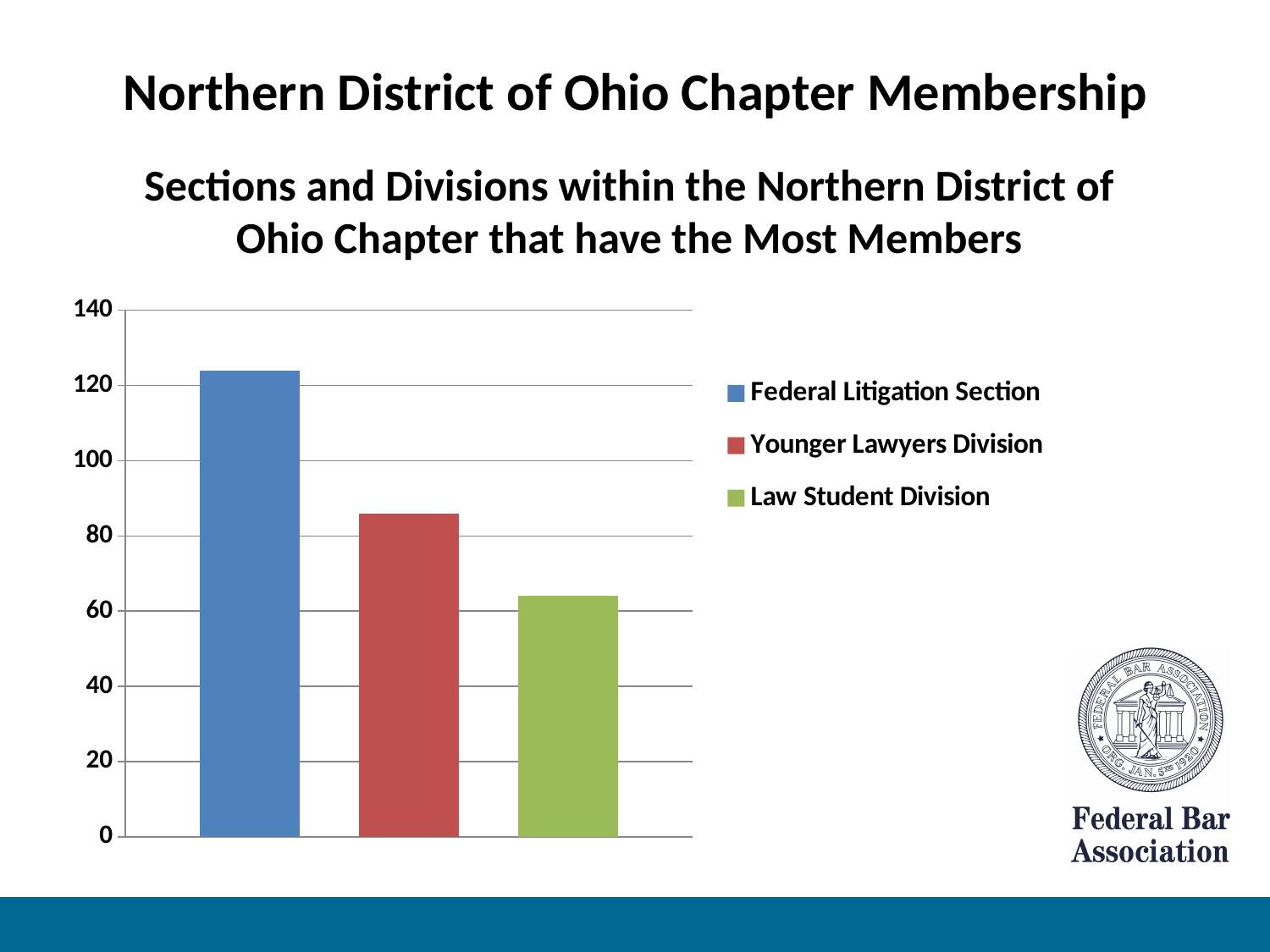
Which section or division has the highest number of members? Federal Litigation Section How many bars are plotted in the chart? 3 Is the value for the Federal Litigation Section greater or less than 100? greater What colour is the bar for the Younger Lawyers Division? red Which section or division has the lowest number of members? Law Student Division Which has more members, the Younger Lawyers Division or the Law Student Division? Younger Lawyers Division What kind of chart is shown on the slide? bar chart Is the value for the Younger Lawyers Division greater or less than 100? less Do the bar values rise or fall from left to right across the chart? fall How many series does the legend list? 3 Is the value for the Law Student Division greater or less than 80? less